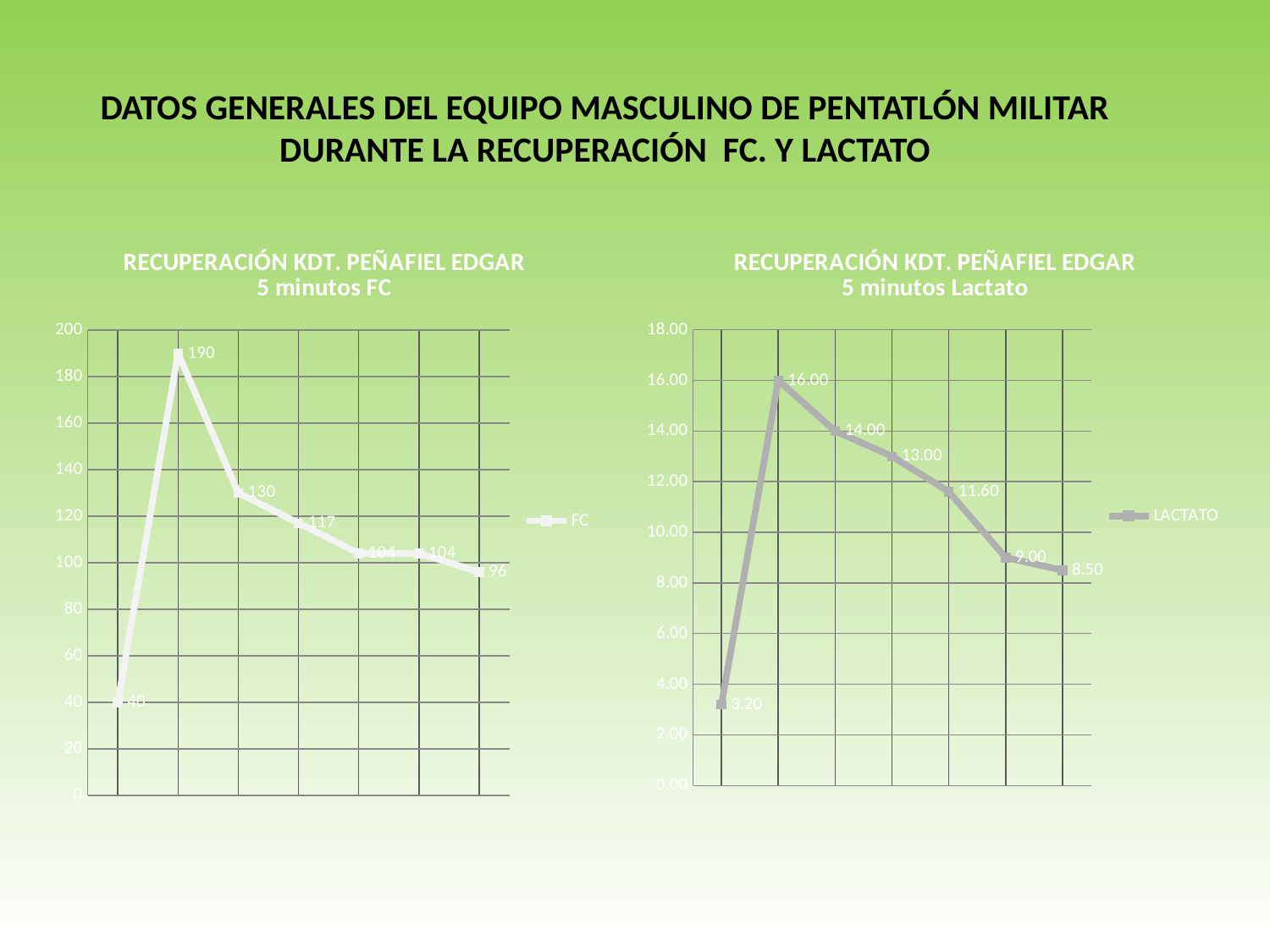
In the left chart (5 minutos FC), what is the value of the last point on the line? 96 What series name does the legend of the right chart show? LACTATO In the right chart (5 minutos Lactato), what is the highest value plotted? 16.00 In the left chart (5 minutos FC), how many data points are plotted on the line? 7 In the left chart (5 minutos FC), what is the highest value plotted? 190 What kind of chart is the left chart (5 minutos FC)? line chart In the right chart (5 minutos Lactato), do the values rise or fall from the second point to the last point? fall In the right chart (5 minutos Lactato), what is the value of the first point on the line? 3.20 In the right chart (5 minutos Lactato), what is the value of the last point on the line? 8.50 In the left chart (5 minutos FC), what is the lowest value plotted? 40 In the right chart (5 minutos Lactato), what is the difference between the second point (16.00) and the third point (14.00)? 2.00 In the left chart (5 minutos FC), what is the difference between the highest value (190) and the first value (40)? 150